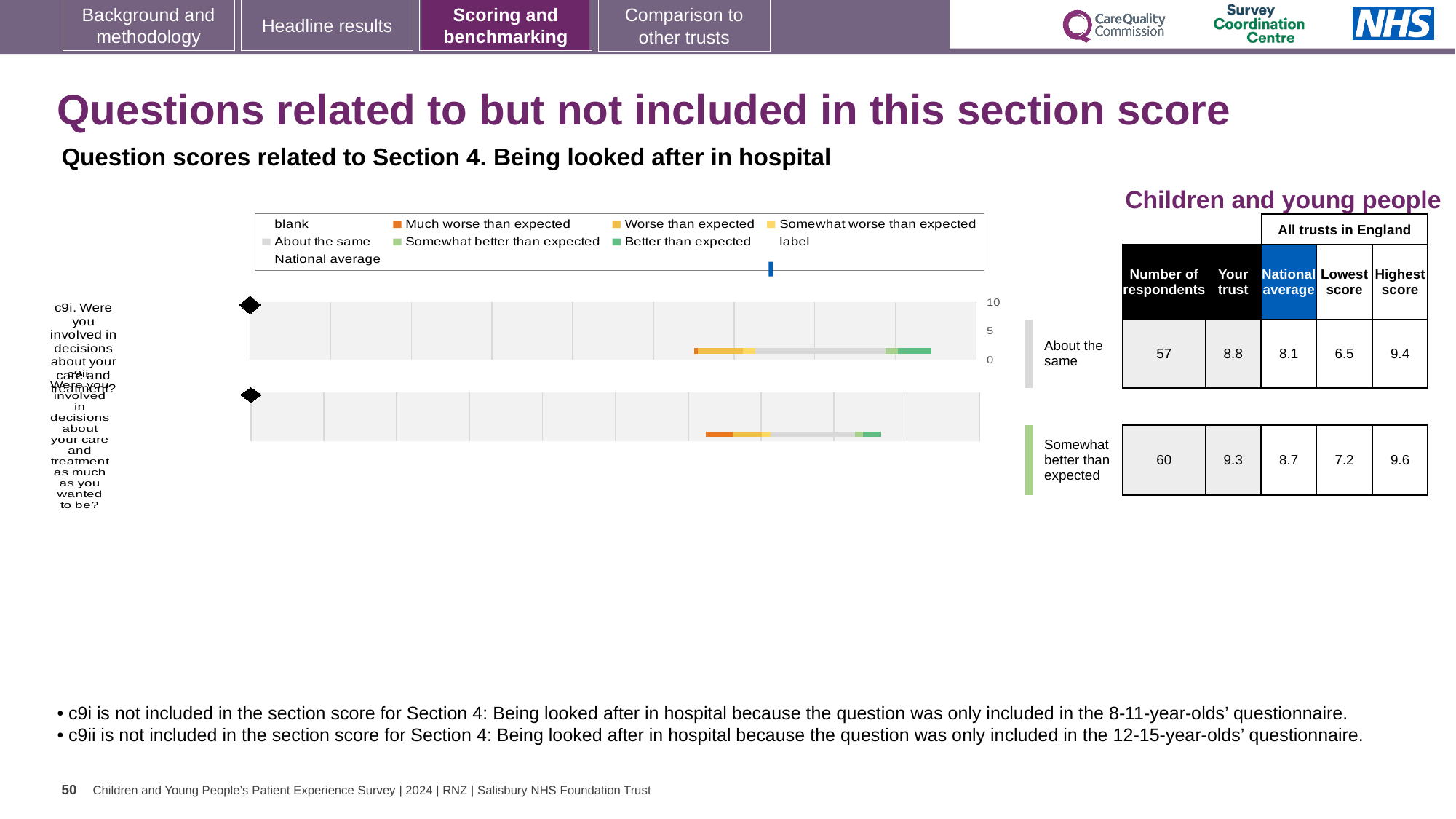
What is the 'Your trust' score for c9i (involved in decisions about your care and treatment)? 8.8 What is the 'Your trust' score for c9ii (involved in decisions as much as you wanted to be)? 9.3 What is the highest score among all trusts in England for c9ii? 9.6 How many questions (bars) are plotted in the chart? 2 What type of chart is used to show the question scores for c9i and c9ii? bar chart How many respondents answered c9ii? 60 Which question has the higher 'Your trust' score, c9i or c9ii? c9ii What is the difference between the highest and lowest scores for c9i? 2.9 What is the difference between the 'Your trust' score and the national average for c9i? 0.7 What benchmark category is shown next to the bar for c9i? About the same What is the national average score for c9i? 8.1